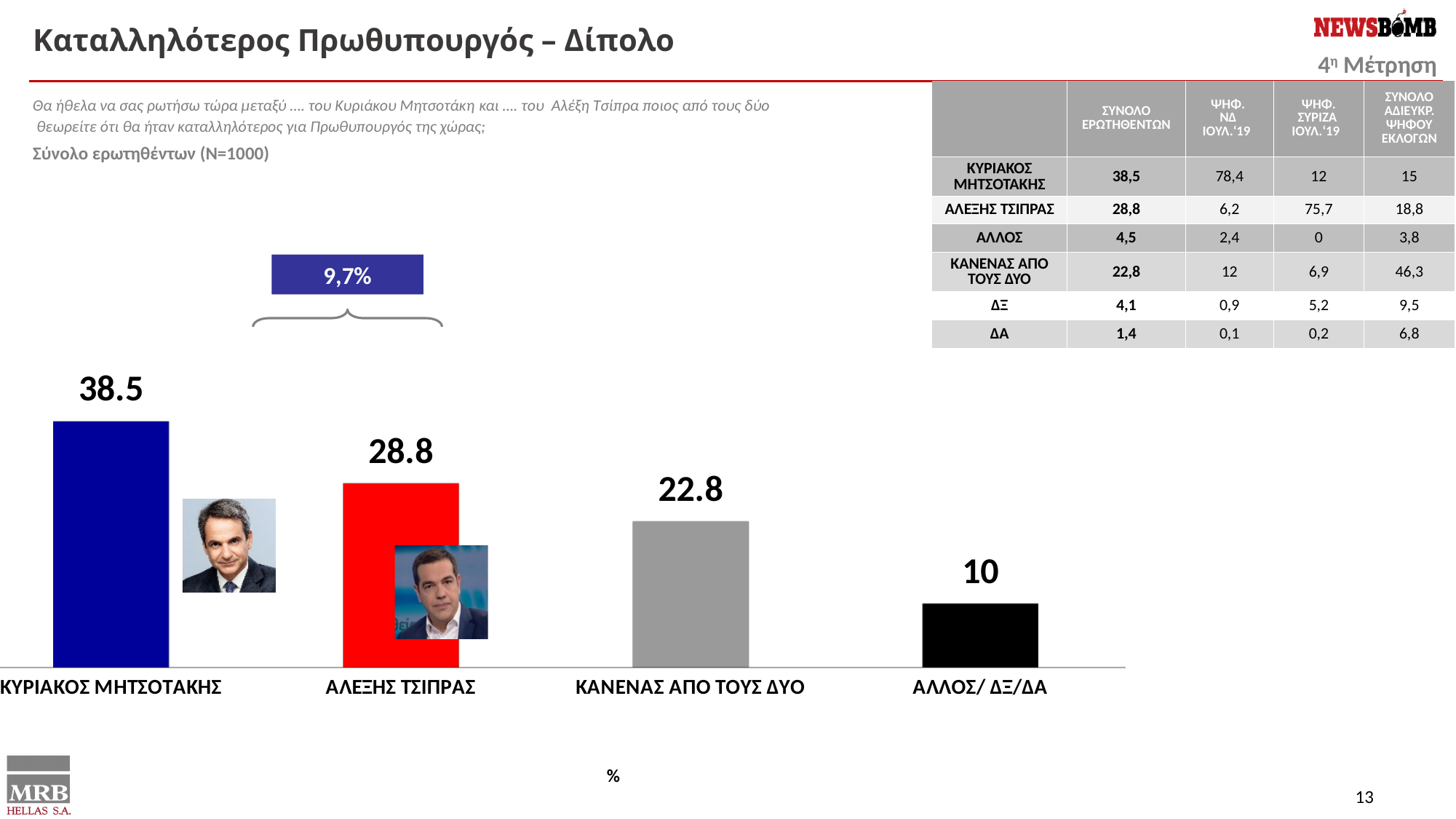
What is the value shown for ΑΛΕΞΗΣ ΤΣΙΠΡΑΣ in the bar chart? 28.8 What is the value shown for ΑΛΛΟΣ/ ΔΞ/ΔΑ in the bar chart? 10 Do the bar values rise or fall from left to right across the chart? Fall Which category has the highest bar in the chart? ΚΥΡΙΑΚΟΣ ΜΗΤΣΟΤΑΚΗΣ What is the difference between the values for ΑΛΕΞΗΣ ΤΣΙΠΡΑΣ and ΚΑΝΕΝΑΣ ΑΠΟ ΤΟΥΣ ΔΥΟ in the bar chart? 6 What is the difference between the values for ΚΥΡΙΑΚΟΣ ΜΗΤΣΟΤΑΚΗΣ and ΑΛΕΞΗΣ ΤΣΙΠΡΑΣ in the bar chart? 9.7 How many categories are shown in the bar chart? 4 What kind of chart is shown on the slide? Bar chart Which category has the lowest bar in the chart? ΑΛΛΟΣ/ ΔΞ/ΔΑ Which is larger in the bar chart: the value for ΚΑΝΕΝΑΣ ΑΠΟ ΤΟΥΣ ΔΥΟ or the value for ΑΛΛΟΣ/ ΔΞ/ΔΑ? ΚΑΝΕΝΑΣ ΑΠΟ ΤΟΥΣ ΔΥΟ What is the value shown for ΚΥΡΙΑΚΟΣ ΜΗΤΣΟΤΑΚΗΣ in the bar chart? 38.5 What is the value shown for ΚΑΝΕΝΑΣ ΑΠΟ ΤΟΥΣ ΔΥΟ in the bar chart? 22.8